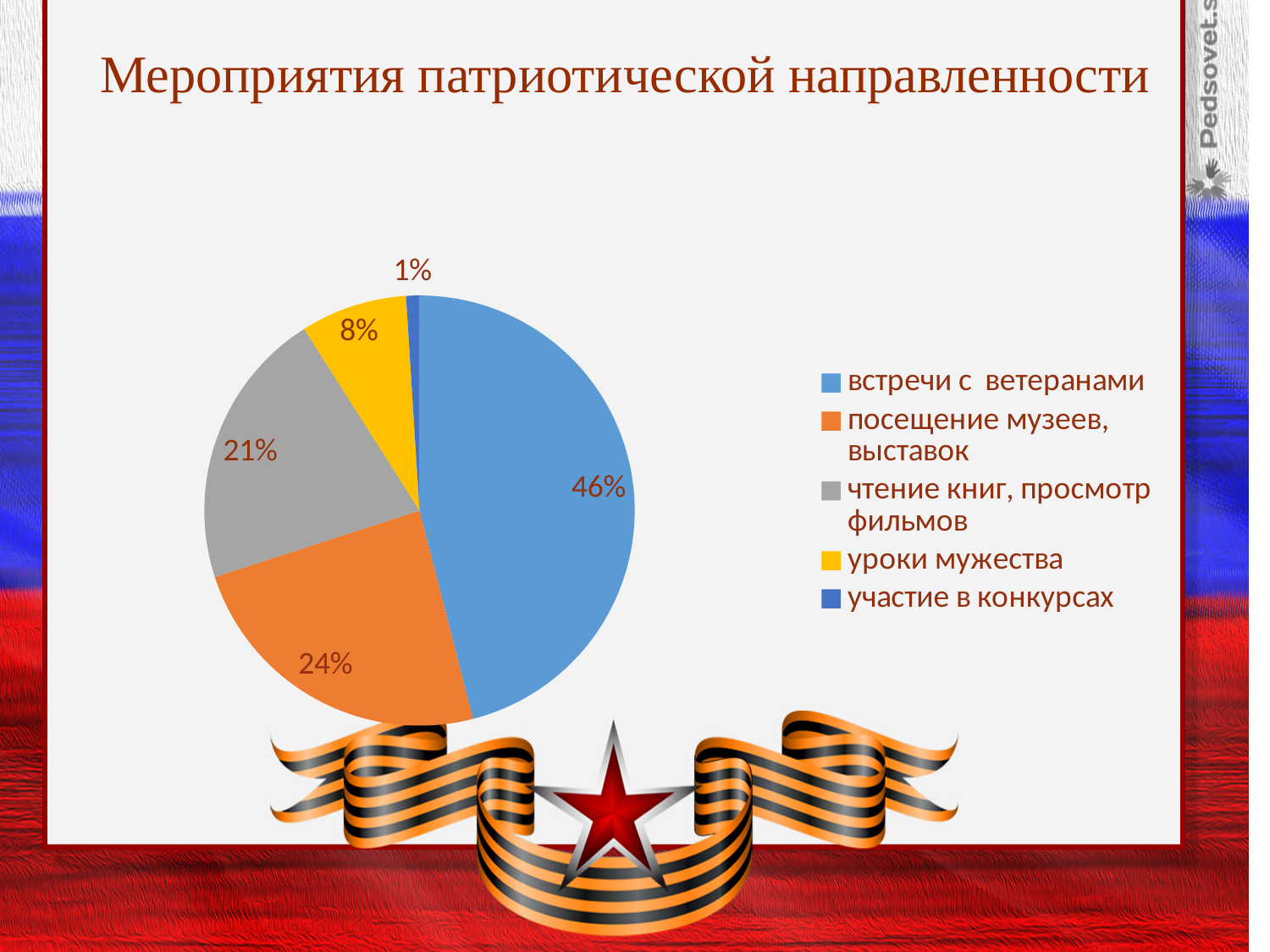
What is the value shown for "чтение книг, просмотр фильмов"? 21% What kind of chart is shown on the slide? pie chart Which category has the largest slice of the pie? встречи с ветеранами How many categories does the pie chart have? 5 Which category has the smallest slice of the pie? участие в конкурсах What is the difference between the shares for "встречи с ветеранами" and "посещение музеев, выставок"? 22% What is the title of the slide? Мероприятия патриотической направленности Which is larger: the share for "чтение книг, просмотр фильмов" or the share for "уроки мужества"? чтение книг, просмотр фильмов What is the value shown for "уроки мужества"? 8% What is the value shown for "участие в конкурсах"? 1% What is the value shown for "посещение музеев, выставок"? 24% What share of the pie does "встречи с ветеранами" take? 46%